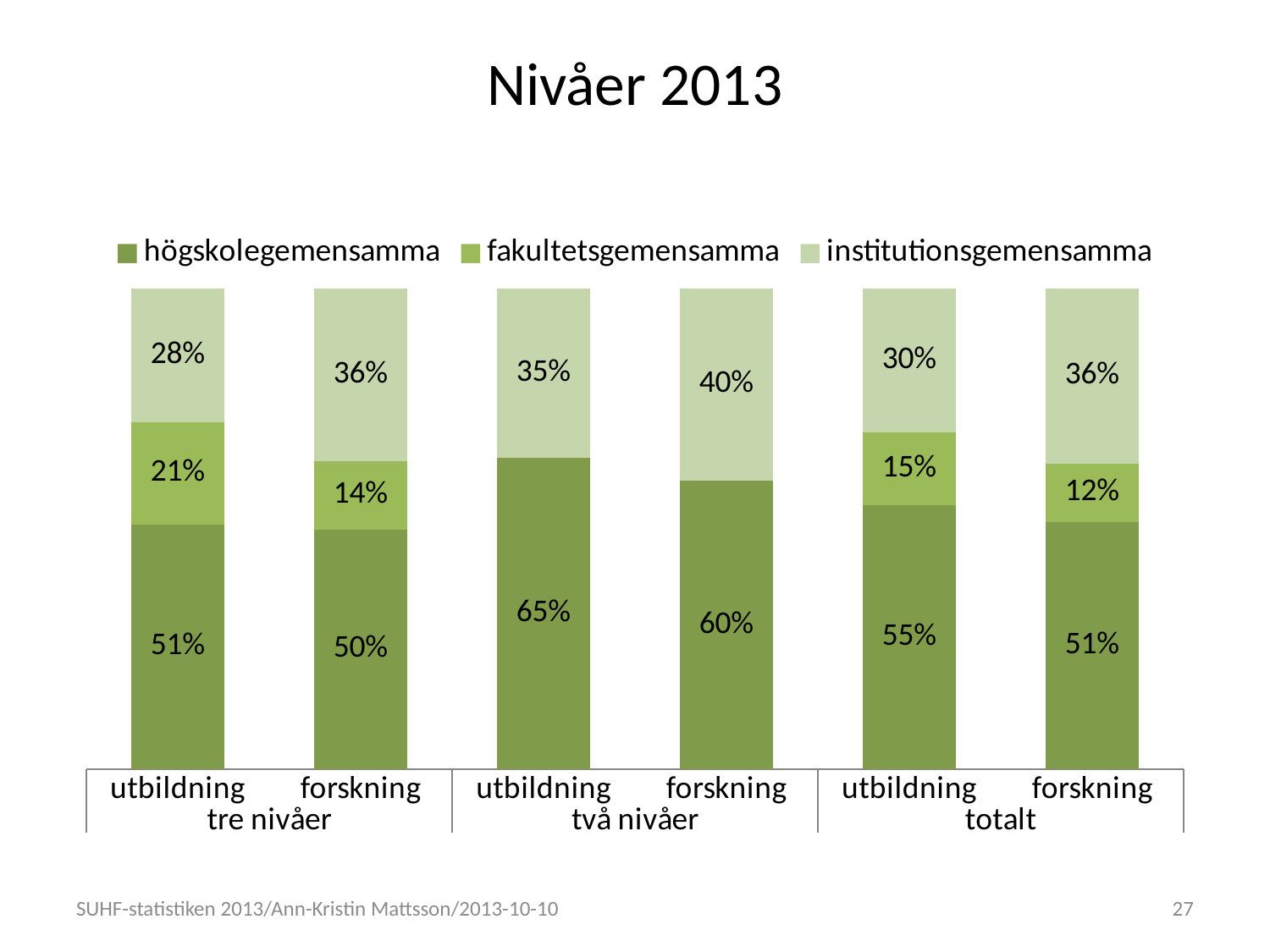
What is the högskolegemensamma share for utbildning under tre nivåer? 51% How many bars are shown in the chart? 6 Which is larger: the institutionsgemensamma share for forskning under tre nivåer or for utbildning under totalt? forskning under tre nivåer What is the difference between the fakultetsgemensamma shares for utbildning and forskning under tre nivåer? 7 percentage points What is the institutionsgemensamma share for forskning under två nivåer? 40% What kind of chart is shown on the slide? Stacked bar chart How many series does the legend list? 3 Which bar has the lowest institutionsgemensamma share? utbildning, tre nivåer Which bar has the highest högskolegemensamma share? utbildning, två nivåer What is the title of the chart? Nivåer 2013 What is the fakultetsgemensamma share for forskning under totalt? 12% What is the högskolegemensamma share for utbildning under två nivåer? 65%